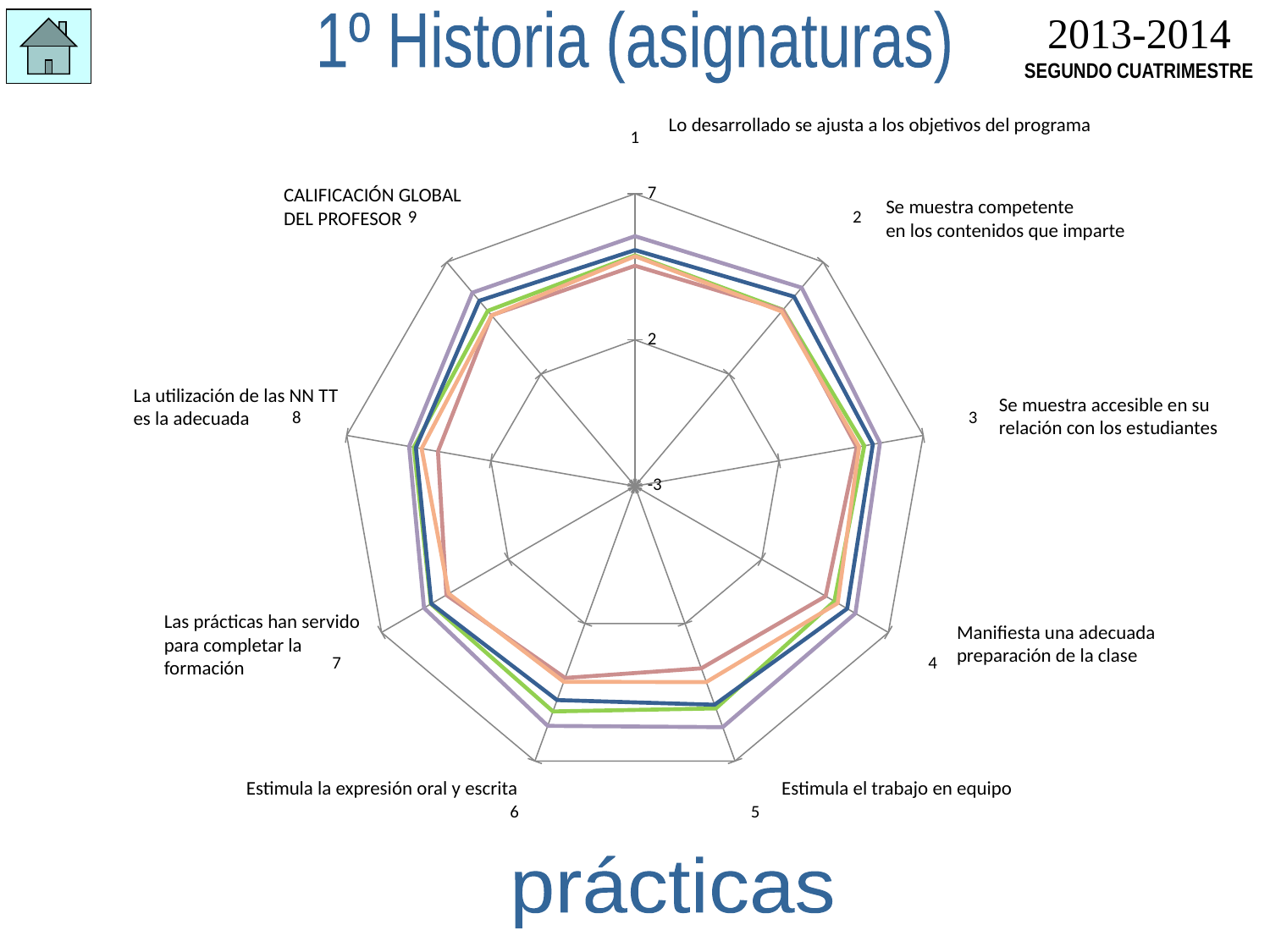
Is the value of the outer purple series for 'Lo desarrollado se ajusta a los objetivos del programa' greater or less than 7? less What is the title of the chart at the top of the slide? 1º Historia (asignaturas) What kind of chart is shown on the slide? radar chart Is the value of the outer purple series for 'Se muestra accesible en su relación con los estudiantes' greater or less than 2? greater Which category label is numbered 5 on the radar chart? Estimula el trabajo en equipo How many categories (axes) does the radar chart have? 9 Is the value of the innermost series for 'Estimula el trabajo en equipo' greater or less than 2? greater